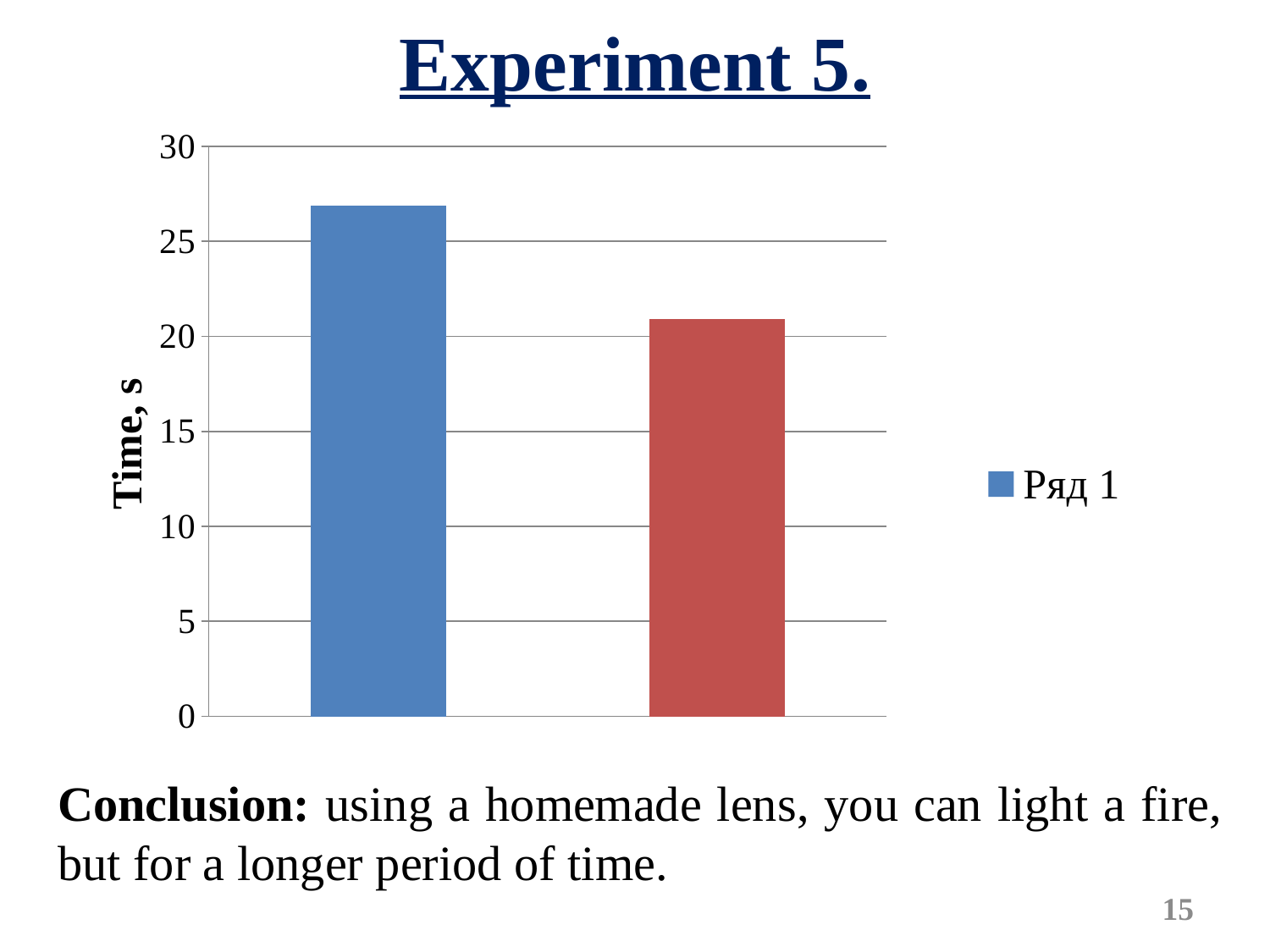
What is the title of the vertical axis of the chart? Time, s Is the value of the blue bar on the left greater or less than 25? greater How many bars are plotted in the chart? 2 How many series does the chart legend list? 1 Is the value of the red bar on the right greater or less than 25? less Which bar shows the lowest value? the red bar on the right Which bar is taller, the blue bar on the left or the red bar on the right? the blue bar on the left What is the name of the series shown in the chart legend? Ряд 1 What kind of chart is shown on the slide? bar chart Is the value of the red bar on the right greater or less than 20? greater Which bar shows the highest value? the blue bar on the left